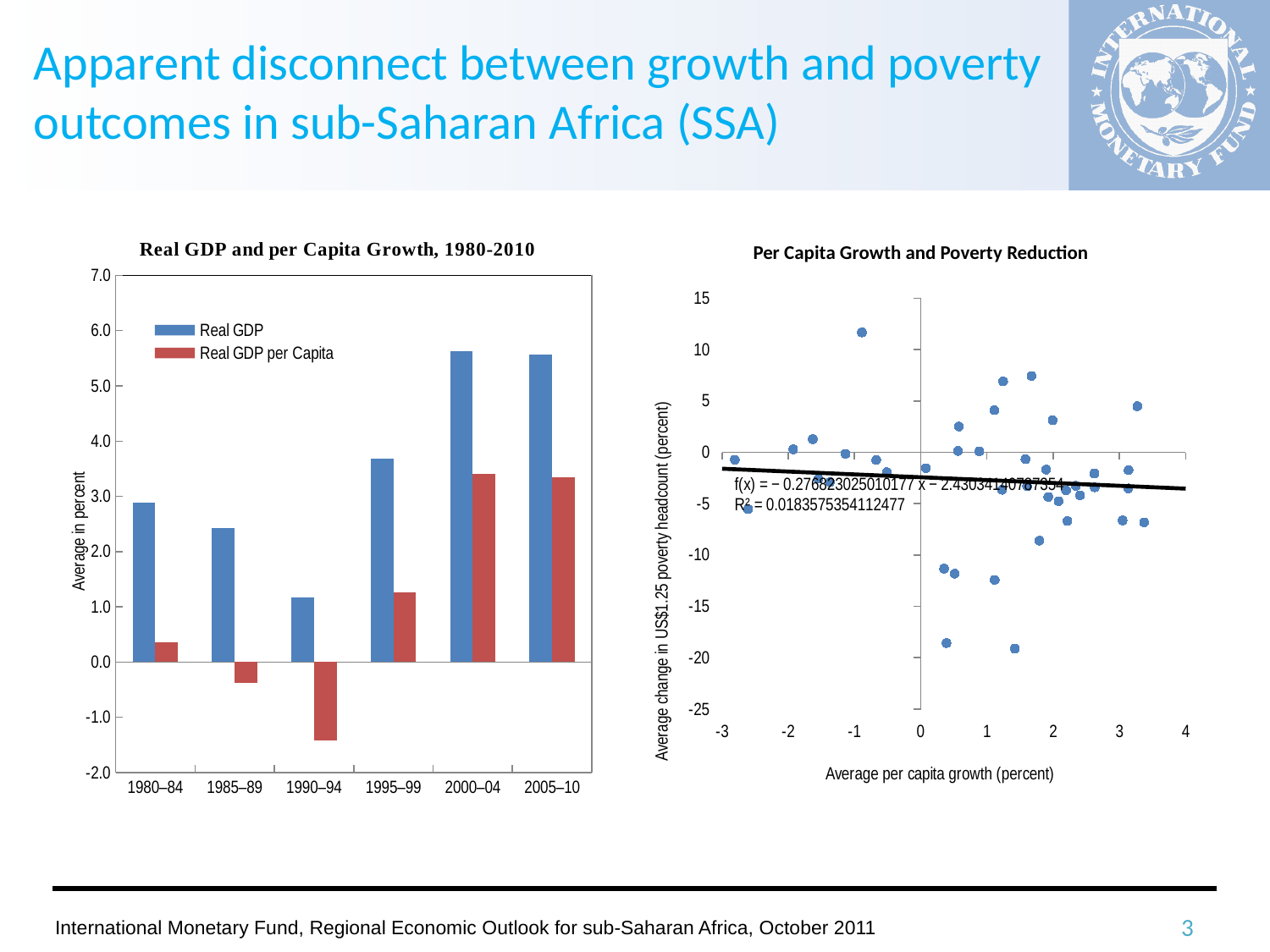
In the 'Real GDP and per Capita Growth, 1980-2010' chart, is Real GDP growth for 2000–04 greater or less than 5.0? greater In the 'Real GDP and per Capita Growth, 1980-2010' chart, which period has the lowest Real GDP growth? 1990–94 What kind of chart is the 'Per Capita Growth and Poverty Reduction' chart? scatter chart In the 'Real GDP and per Capita Growth, 1980-2010' chart, is Real GDP growth for 1995–99 greater or less than 3.0? greater What R² value is printed on the 'Per Capita Growth and Poverty Reduction' chart? 0.0183575354112477 In the 'Real GDP and per Capita Growth, 1980-2010' chart, is Real GDP per Capita growth for 1990–94 greater or less than -1.0? less How many time periods are shown on the x axis of the 'Real GDP and per Capita Growth, 1980-2010' chart? 6 In the 'Real GDP and per Capita Growth, 1980-2010' chart, which is larger: Real GDP growth in 1980–84 or in 1985–89? 1980–84 In the 'Real GDP and per Capita Growth, 1980-2010' chart, does Real GDP growth rise or fall from 1990–94 to 2000–04? rise What kind of chart is the 'Real GDP and per Capita Growth, 1980-2010' chart? bar chart In the 'Real GDP and per Capita Growth, 1980-2010' chart, which period has the lowest Real GDP per Capita growth? 1990–94 How many series does the legend of the 'Real GDP and per Capita Growth, 1980-2010' chart list? 2